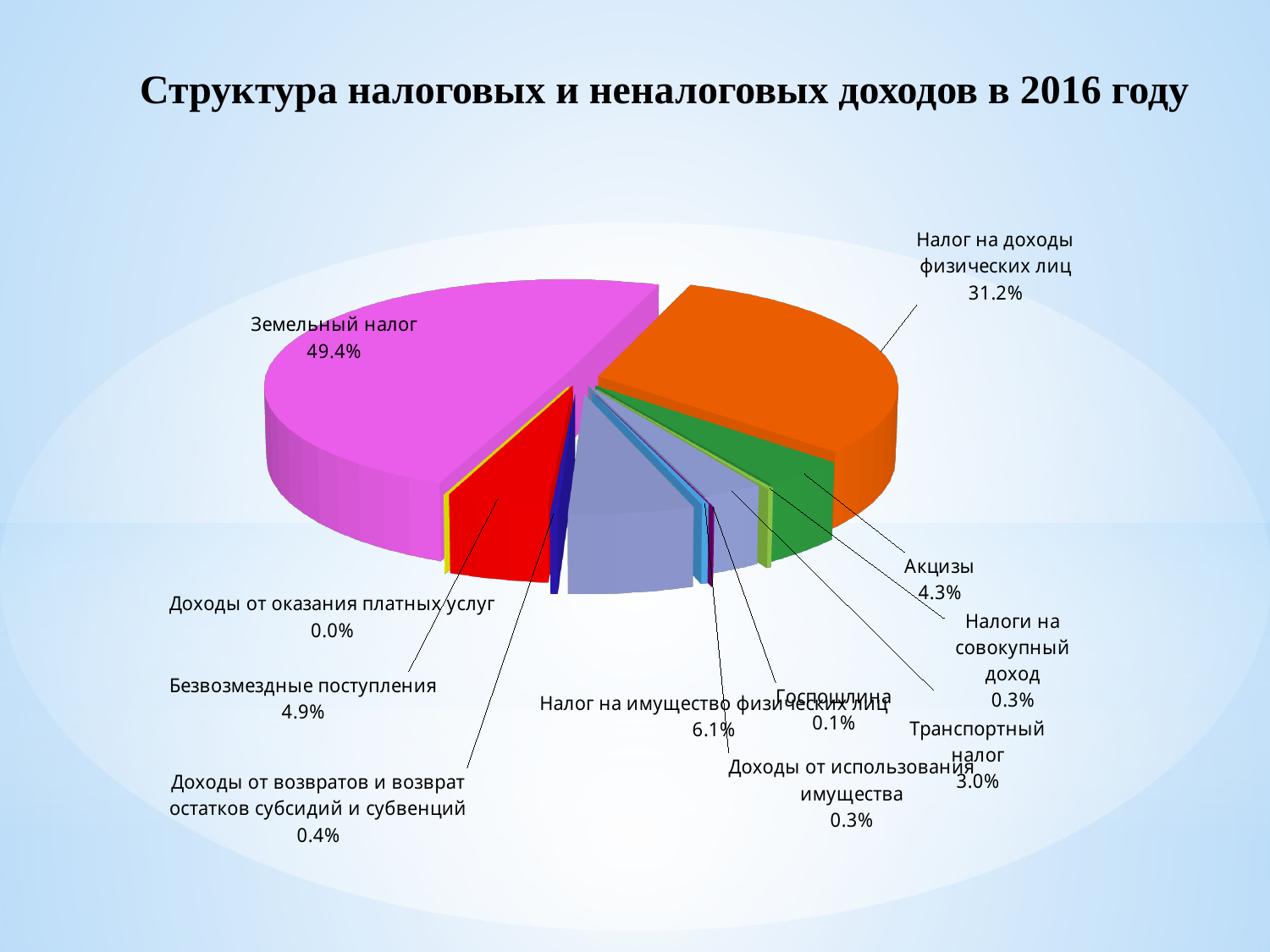
What is the value shown for Транспортный налог? 3.0% What is the value shown for Безвозмездные поступления? 4.9% How many categories are shown in the pie chart? 11 Which is larger, the share of Налог на имущество физических лиц or the share of Безвозмездные поступления? Налог на имущество физических лиц What kind of chart is shown on the slide? Pie chart What is the value shown for Акцизы? 4.3% What share of the pie is Земельный налог? 49.4% Which category has the smallest share of the pie? Доходы от оказания платных услуг Which category has the largest share of the pie? Земельный налог What share of the pie is Налог на доходы физических лиц? 31.2% What is the title of the chart? Структура налоговых и неналоговых доходов в 2016 году What is the difference between the shares of Земельный налог and Налог на доходы физических лиц? 18.2%